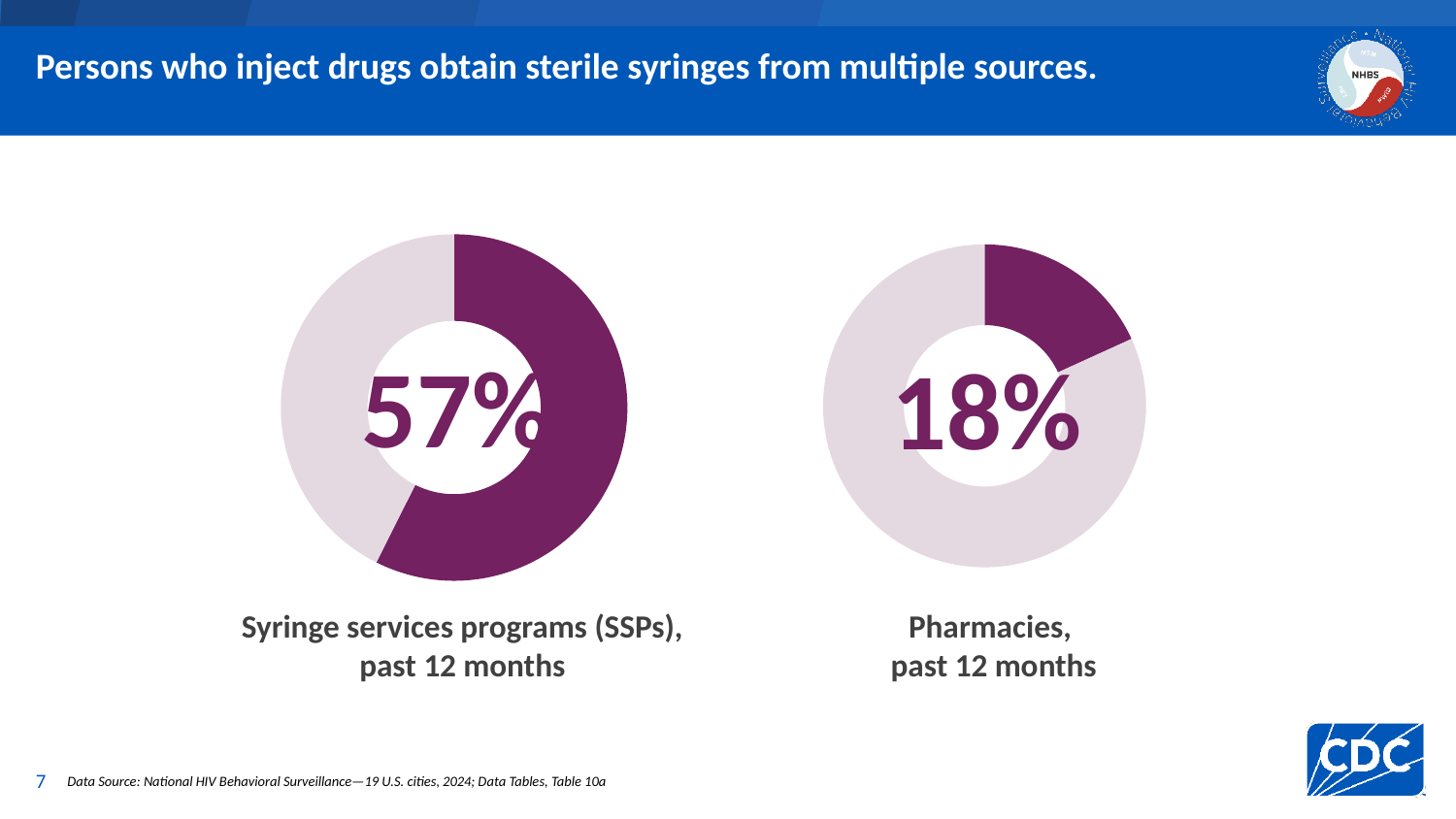
What kind of chart is used on the left to show the SSP percentage? Donut (pie) chart On the right chart, what share of the donut is filled with the dark purple colour? 18% Is the value on the Pharmacies chart greater or less than 50%? less On the left chart (Syringe services programs), what percentage is shown in the center? 57% What is the difference in percentage points between the SSP chart value and the Pharmacies chart value? 39 Is the value on the SSP chart greater or less than 50%? greater Which source has the higher percentage, syringe services programs or pharmacies? Syringe services programs (SSPs) How many donut charts are shown on the slide? 2 What is the label under the right chart? Pharmacies, past 12 months On the right chart (Pharmacies), what percentage is shown in the center? 18% What is the title of the slide? Persons who inject drugs obtain sterile syringes from multiple sources. On the left chart, what share of the donut is filled with the dark purple colour? 57%